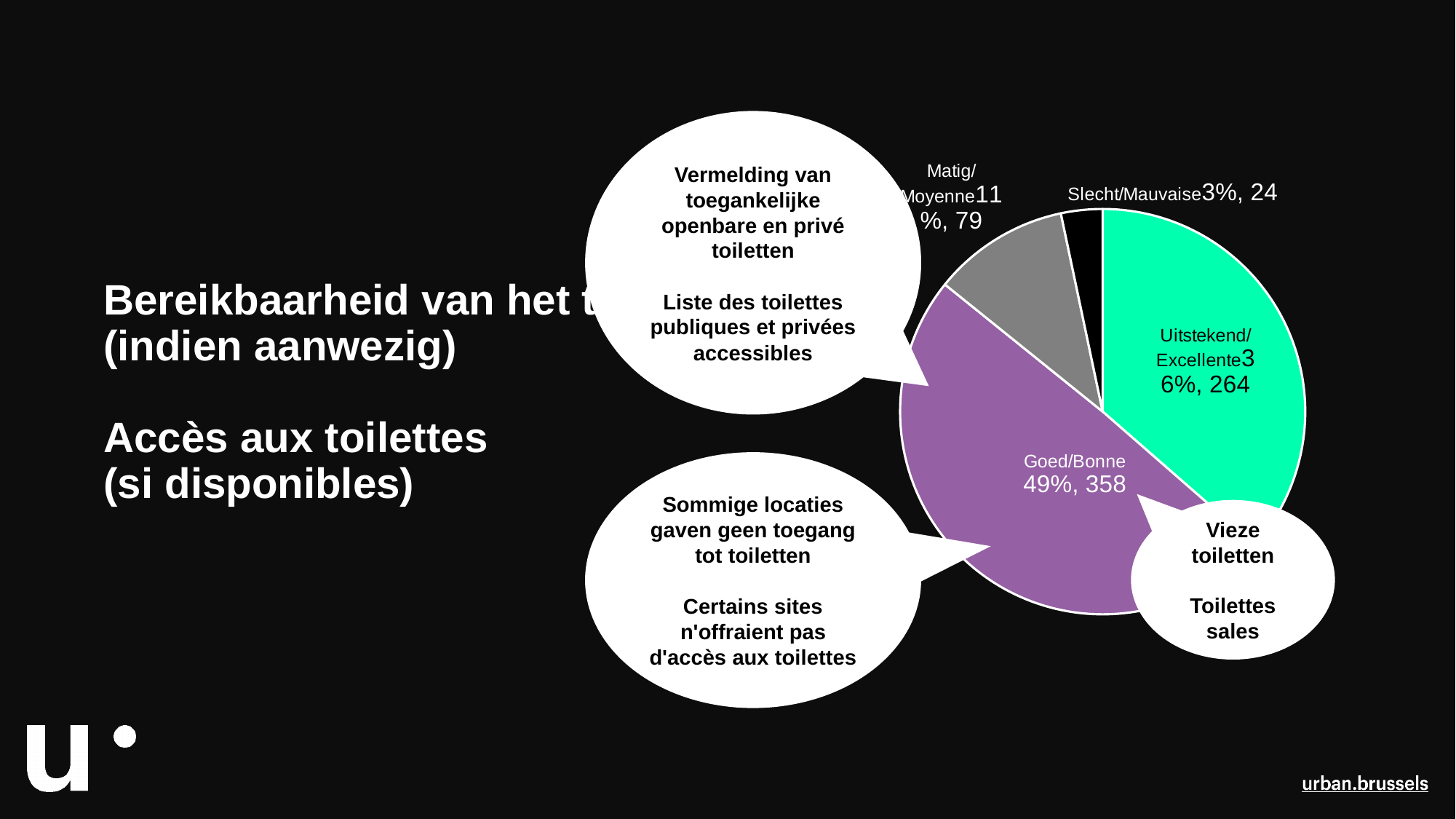
What kind of chart is shown on the slide? pie chart Which category has the smallest slice of the pie? Slecht/Mauvaise What percentage does the Slecht/Mauvaise slice represent? 3% What is the count shown for the Uitstekend/Excellente slice? 264 What is the count shown for the Slecht/Mauvaise slice? 24 What percentage does the Uitstekend/Excellente slice represent? 36% How many slices does the pie chart have? 4 Which category has the largest slice of the pie? Goed/Bonne What percentage does the Goed/Bonne slice represent? 49% What is the count shown for the Goed/Bonne slice? 358 What is the difference in count between Goed/Bonne and Uitstekend/Excellente? 94 What is the count shown for the Matig/Moyenne slice? 79